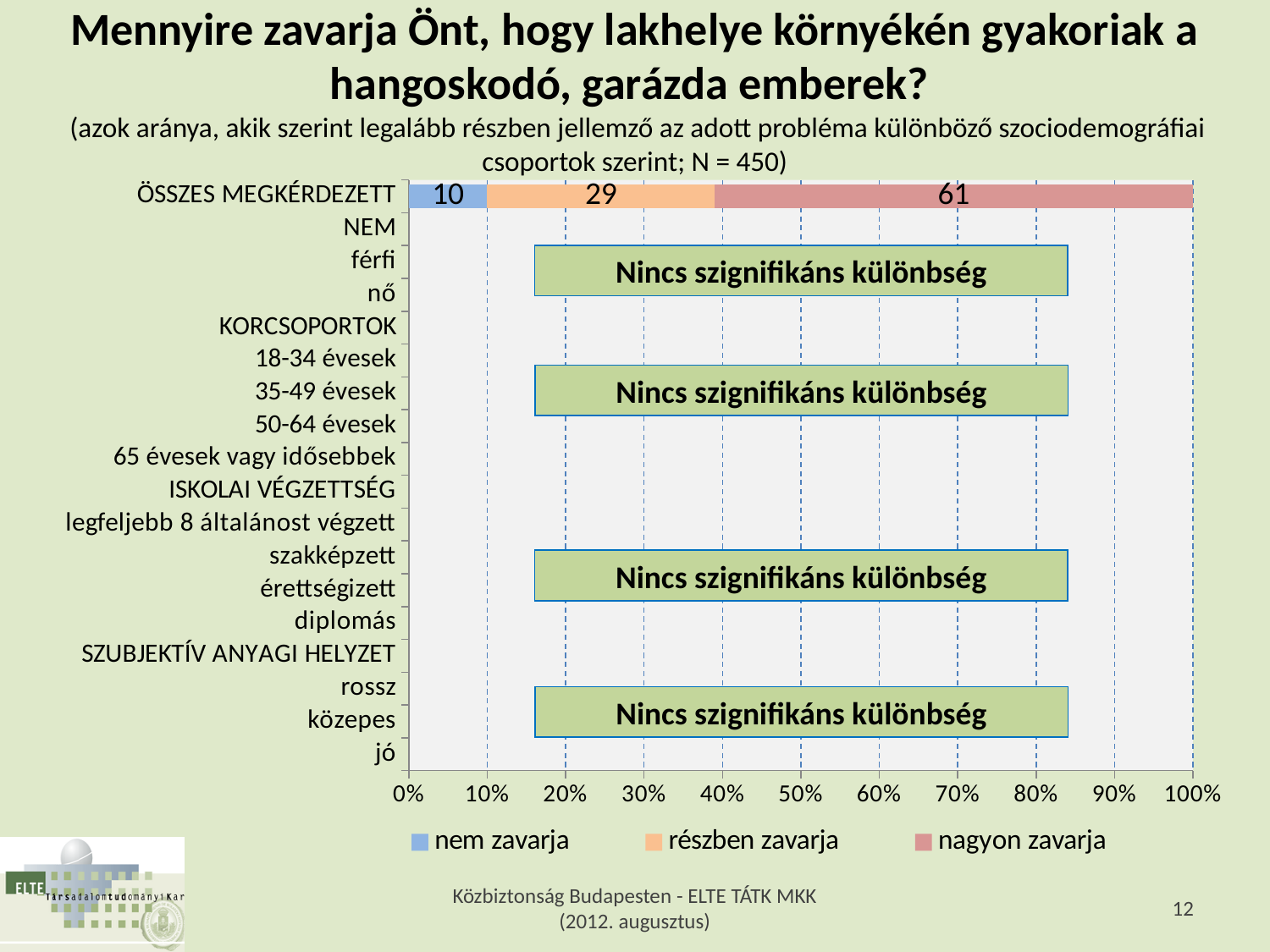
What kind of chart is shown on the slide? stacked bar chart What text appears in the green boxes placed over the empty rows of the chart? Nincs szignifikáns különbség Which series has the largest value in the ÖSSZES MEGKÉRDEZETT bar? nagyon zavarja What is the value for "nagyon zavarja" in the ÖSSZES MEGKÉRDEZETT bar? 61 What is the difference between the "nagyon zavarja" and "részben zavarja" values in the ÖSSZES MEGKÉRDEZETT bar? 32 What is the maximum value shown on the horizontal axis? 100% How many series does the legend list? 3 What is the value for "részben zavarja" in the ÖSSZES MEGKÉRDEZETT bar? 29 Which is larger in the ÖSSZES MEGKÉRDEZETT bar: "részben zavarja" or "nem zavarja"? részben zavarja Which series has the smallest value in the ÖSSZES MEGKÉRDEZETT bar? nem zavarja What is the total of the ÖSSZES MEGKÉRDEZETT stacked bar? 100 What is the value for "nem zavarja" in the ÖSSZES MEGKÉRDEZETT bar? 10